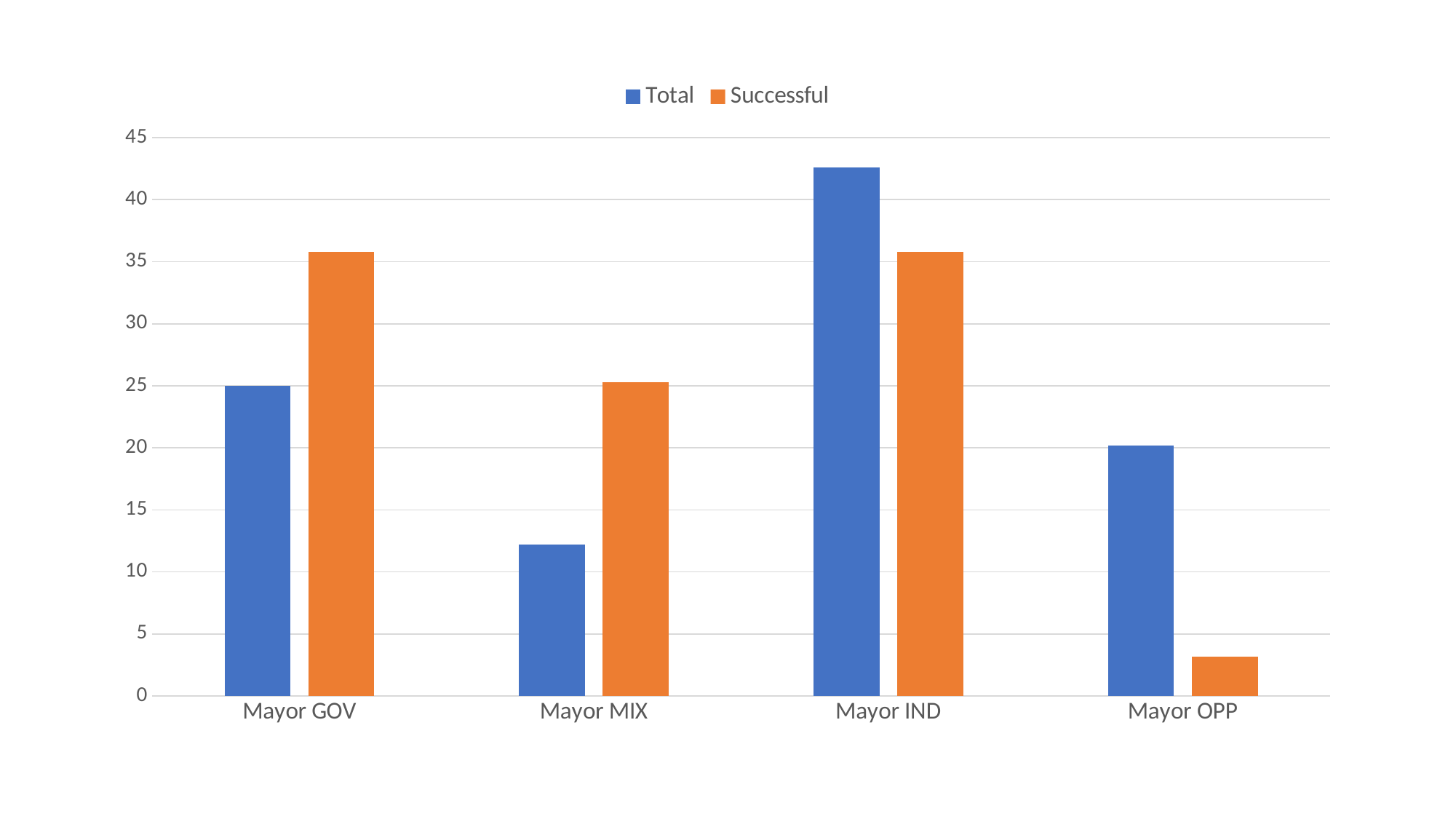
How many categories are shown on the x axis? 4 What kind of chart is shown on the slide? bar chart Which colour represents the Successful series? orange Is the Total value for Mayor MIX greater or less than 15? less Which category has the lowest Total value? Mayor MIX Which category has the lowest Successful value? Mayor OPP Is the Successful value for Mayor GOV greater or less than 30? greater How many series does the legend list? 2 Is the Total value for Mayor IND greater or less than 40? greater Which category has the highest Total value? Mayor IND For Mayor OPP, which is larger, Total or Successful? Total